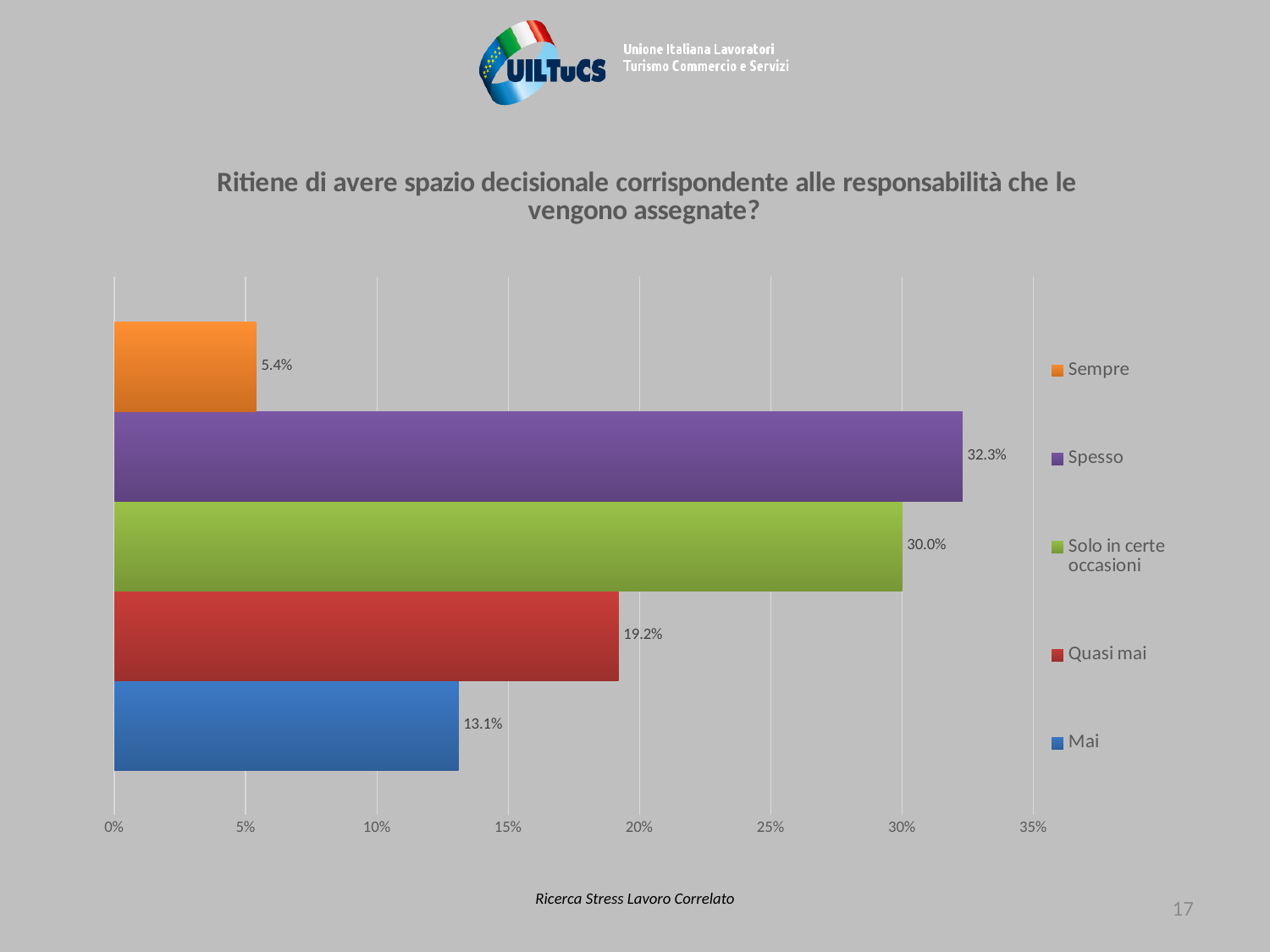
What is the value for Spesso? 32.3% Is the value for Solo in certe occasioni greater or less than 25%? greater What kind of chart is shown on the slide? bar chart How many categories are shown in the chart? 5 What is the value for Sempre? 5.4% Which is larger, the value for Quasi mai or the value for Mai? Quasi mai What is the value for Mai? 13.1% What is the difference between the values for Spesso and Solo in certe occasioni? 2.3% Which category has the lowest value? Sempre What colour is the bar for Solo in certe occasioni? green What is the value for Quasi mai? 19.2% Which category has the highest value? Spesso